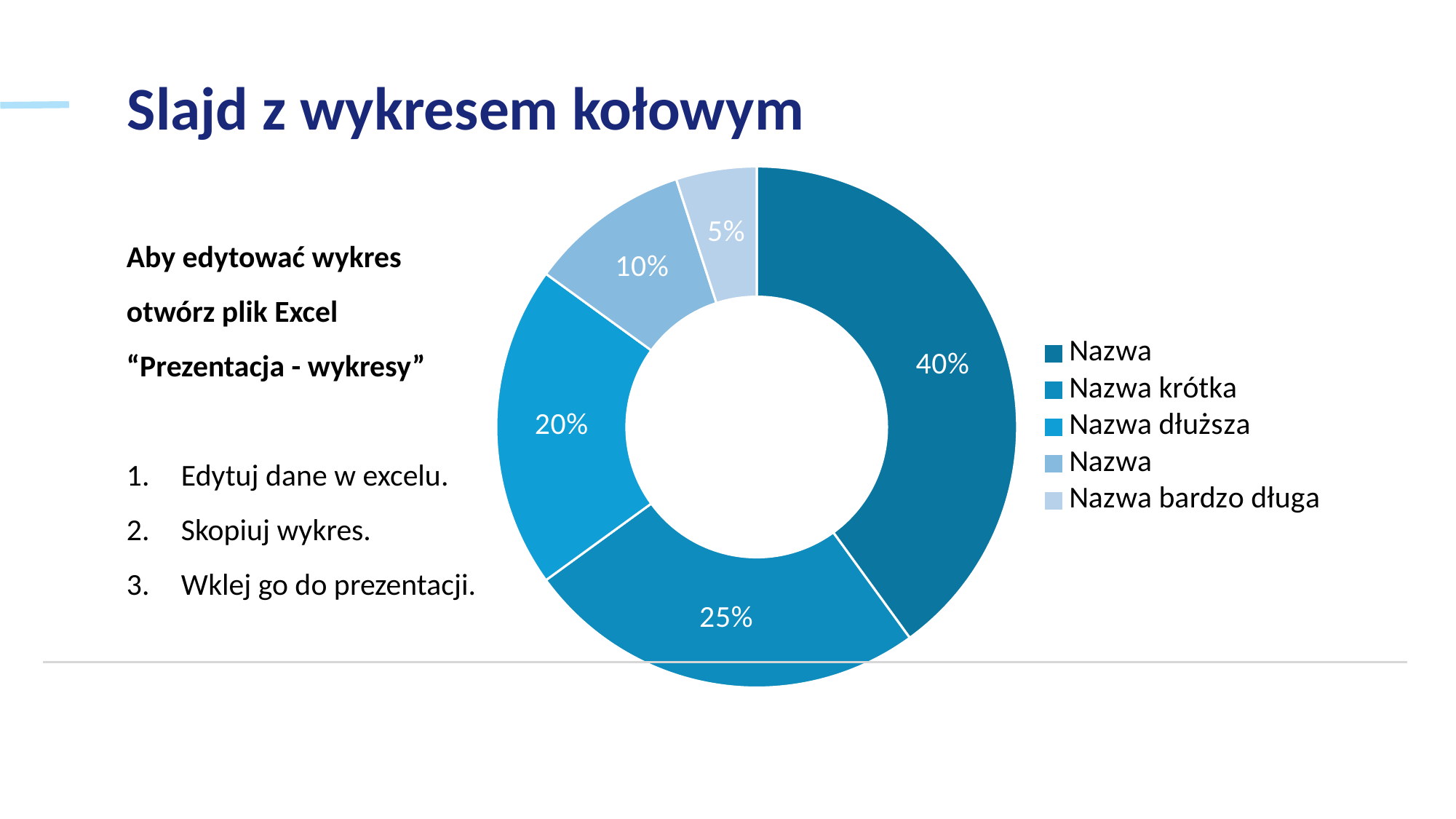
What is the sum of the percentages shown on all slices of the chart? 100% How many entries does the legend list? 5 What percentage is shown for the slice labelled "Nazwa krótka"? 25% What kind of chart is shown on the slide? Pie (donut) chart What is the title of the slide containing the chart? Slajd z wykresem kołowym What percentage is shown for the slice labelled "Nazwa bardzo długa"? 5% Which slice is larger, "Nazwa dłuższa" or "Nazwa bardzo długa"? Nazwa dłuższa How many slices does the chart have? 5 What is the difference in percentage points between the "Nazwa krótka" slice and the "Nazwa dłuższa" slice? 5 percentage points Which legend entry corresponds to the smallest slice of the chart? Nazwa bardzo długa What is the largest percentage shown on the chart? 40% What percentage is shown for the slice labelled "Nazwa dłuższa"? 20%